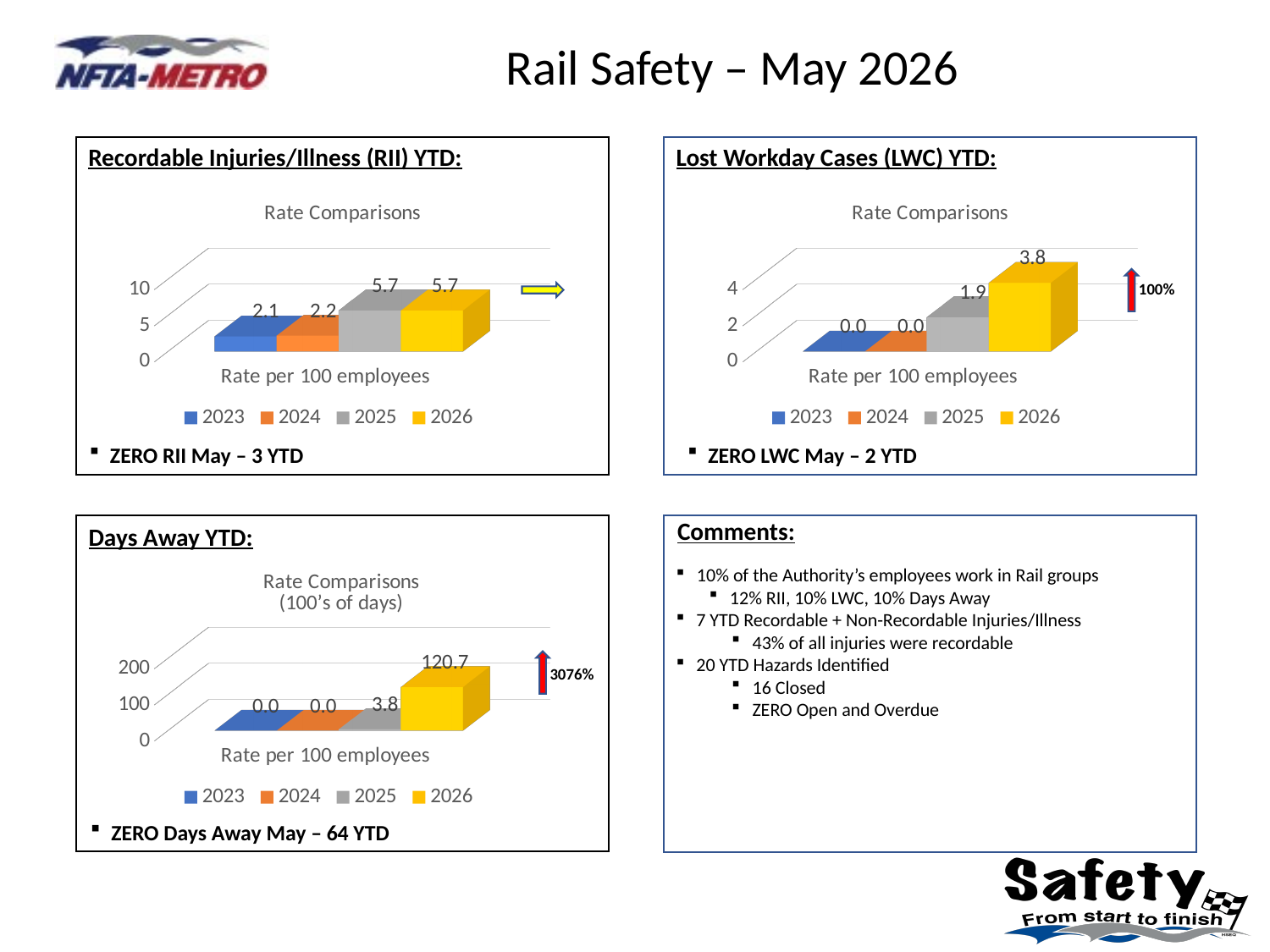
In the Days Away YTD chart, what is the rate for 2026? 120.7 What kind of chart is the Days Away YTD chart? Bar chart In the Lost Workday Cases (LWC) YTD chart, what is the difference between the 2026 and 2025 rates? 1.9 In the Days Away YTD chart, what is the difference between the 2026 and 2025 rates? 116.9 In the Lost Workday Cases (LWC) YTD chart, which year has the highest rate? 2026 In the Recordable Injuries/Illness (RII) YTD chart, what is the rate for 2025? 5.7 In the Lost Workday Cases (LWC) YTD chart, what is the rate for 2026? 3.8 In the Lost Workday Cases (LWC) YTD chart, what is the rate for 2024? 0.0 In the Recordable Injuries/Illness (RII) YTD chart, how many series does the legend list? 4 In the Days Away YTD chart, which is larger, the 2025 rate or the 2026 rate? 2026 In the Recordable Injuries/Illness (RII) YTD chart, what is the difference between the 2024 and 2023 rates? 0.1 In the Recordable Injuries/Illness (RII) YTD chart, what is the rate for 2023? 2.1